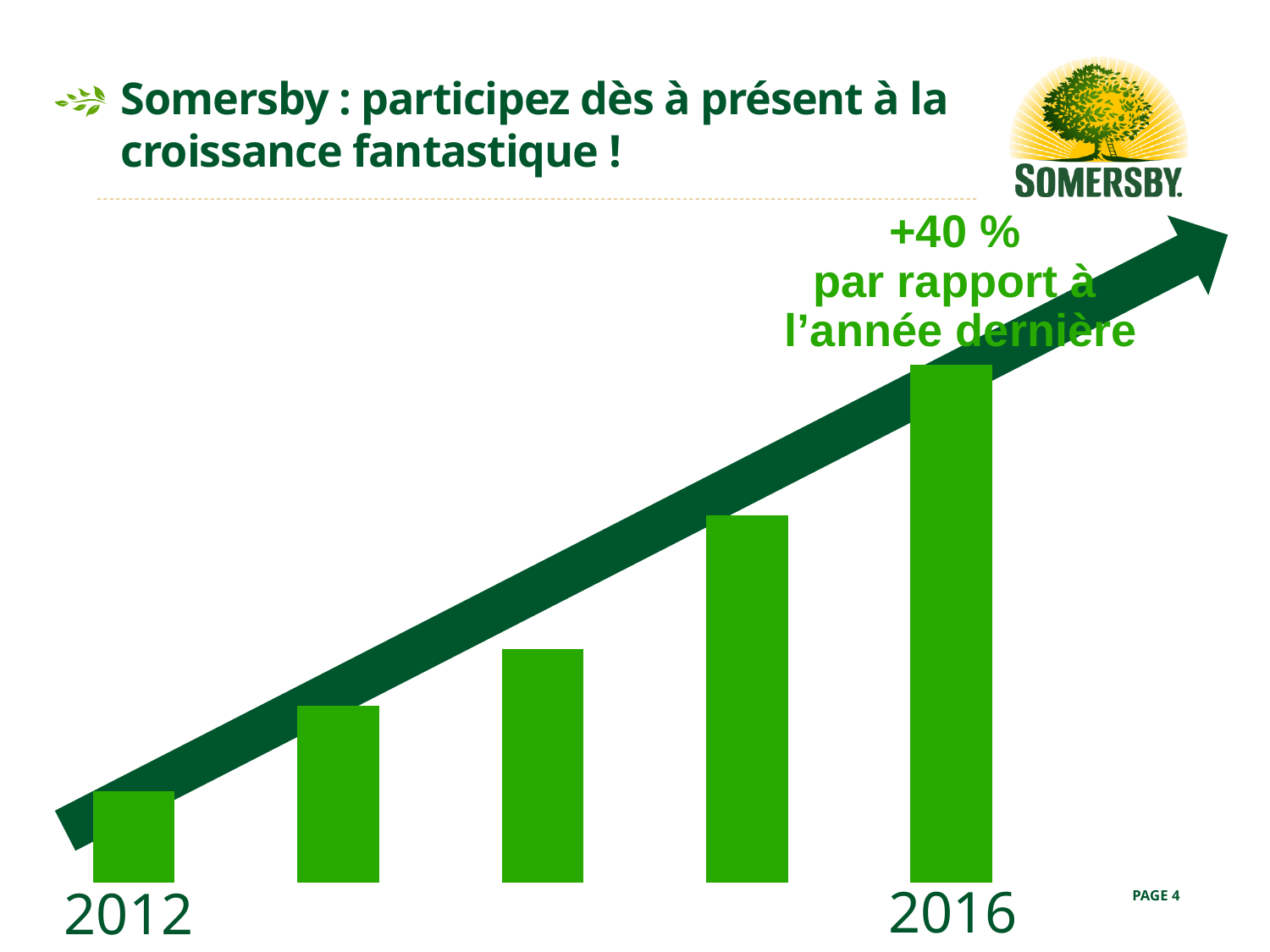
Which year has the shortest bar in the chart? 2012 What growth figure is annotated above the 2016 bar? +40 % Which year has the tallest bar in the chart? 2016 What kind of chart is shown on the slide? bar chart Which bar is taller, 2012 or 2016? 2016 What is the first year labelled on the x axis of the chart? 2012 How many bars are plotted in the chart? 5 Do the bar values rise or fall from 2012 to 2016? rise